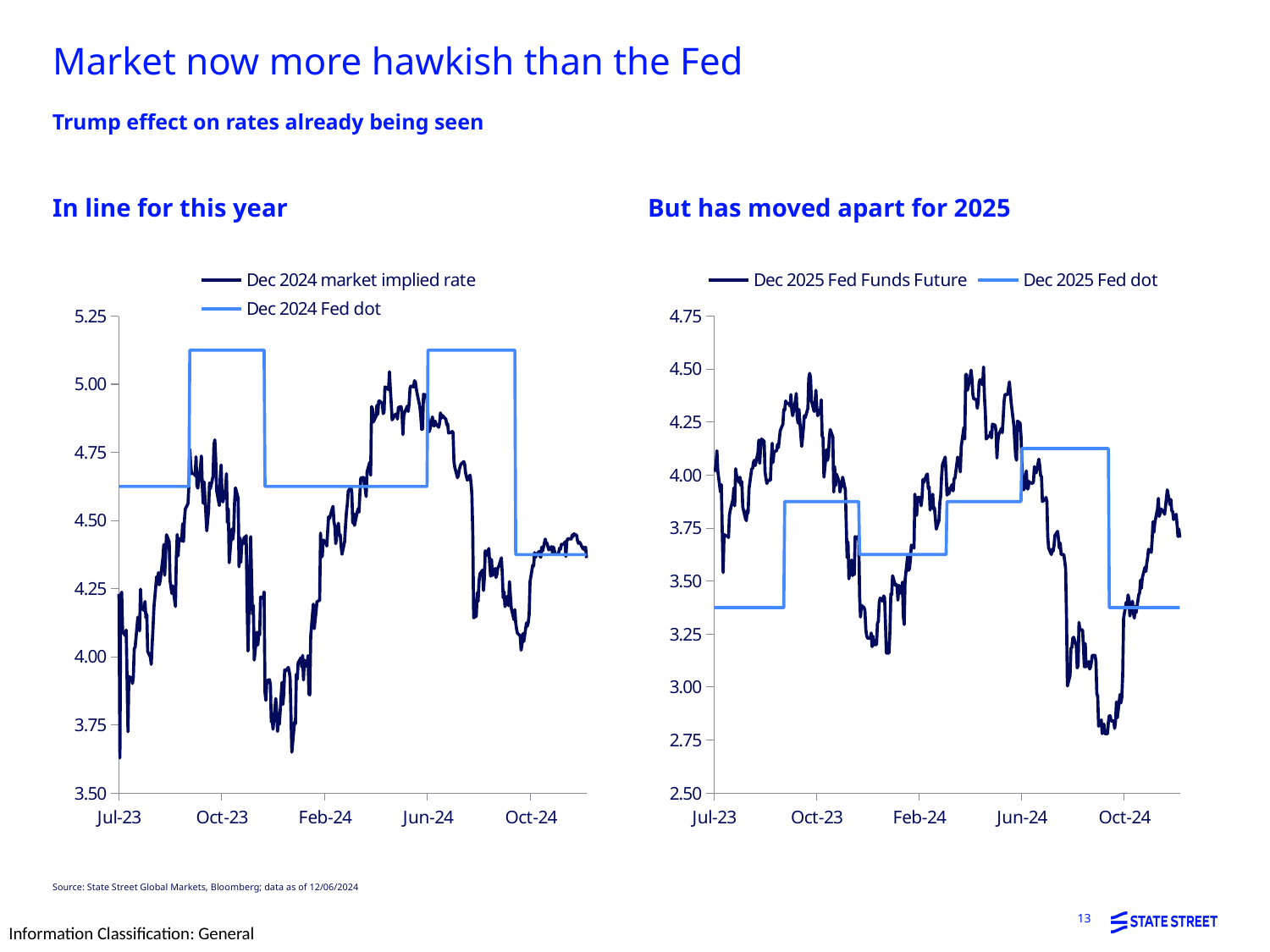
In the right chart ('But has moved apart for 2025'), is the Dec 2025 Fed dot between Jun-24 and Sep-24 greater or less than 4.00? greater How many series does the legend of the right chart ('But has moved apart for 2025') list? 2 What is the title of the left chart on the slide? In line for this year What are the two legend entries of the right chart ('But has moved apart for 2025')? Dec 2025 Fed Funds Future; Dec 2025 Fed dot In the left chart ('In line for this year'), is the Dec 2024 Fed dot at the end of the series (after Oct-24) greater or less than 4.50? less In the right chart ('But has moved apart for 2025'), is the lowest point of the Dec 2025 Fed Funds Future around Oct-24 greater or less than 3.00? less What kind of chart is the left chart titled 'In line for this year'? line chart How many series does the legend of the left chart ('In line for this year') list? 2 How many x-axis date labels are shown on the right chart ('But has moved apart for 2025')? 5